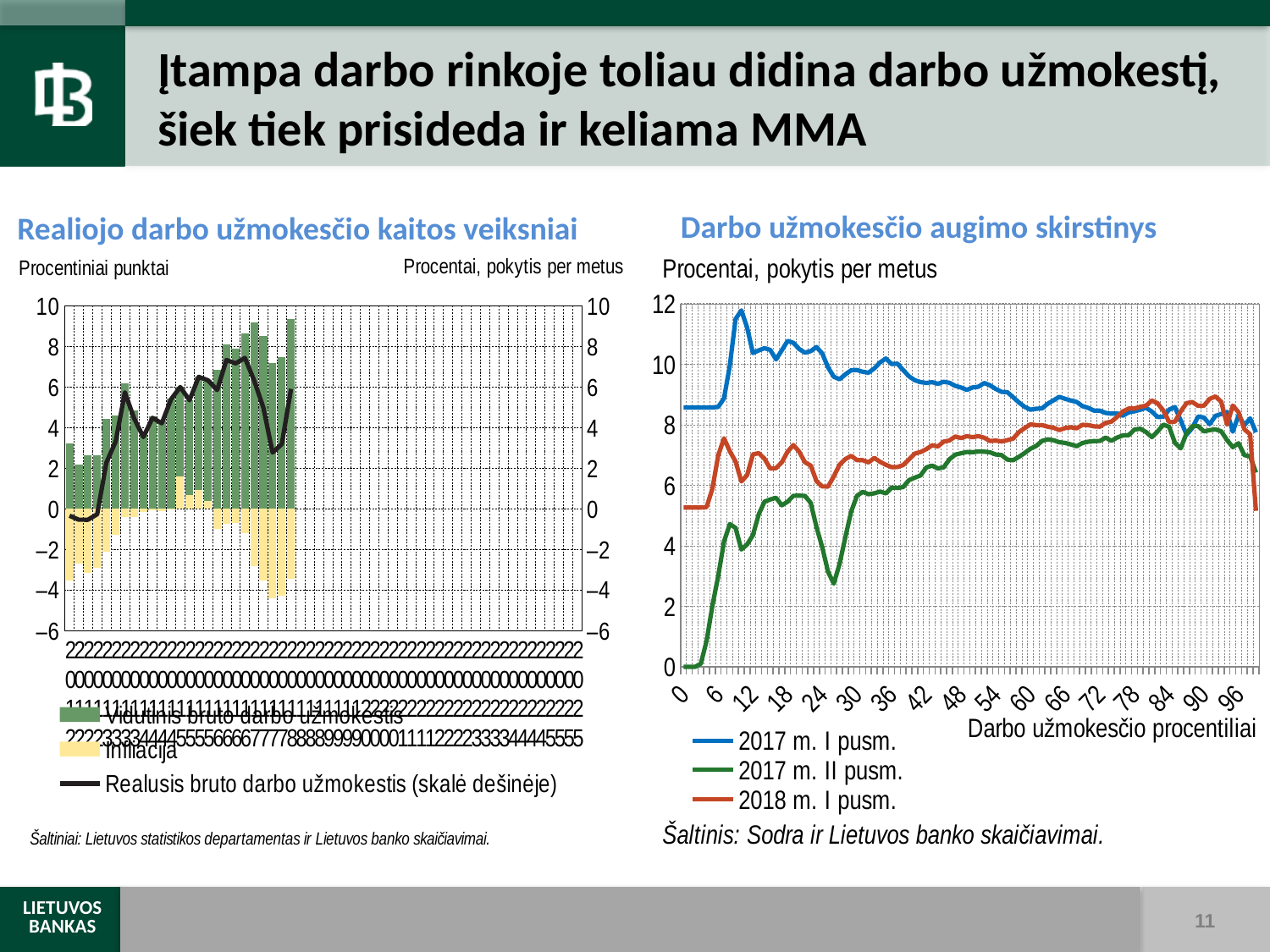
In the right-hand chart "Darbo užmokesčio augimo skirstinys", which series is plotted in red? 2018 m. I pusm. How many series does the legend of the left-hand chart "Realiojo darbo užmokesčio kaitos veiksniai" list? 3 In the right-hand chart "Darbo užmokesčio augimo skirstinys", at percentile 0, which is larger: the 2017 m. I pusm. value or the 2018 m. I pusm. value? 2017 m. I pusm. In the left-hand chart "Realiojo darbo užmokesčio kaitos veiksniai", which series is plotted as a black line on the right-hand scale? Realusis bruto darbo užmokestis (skalė dešinėje) In the right-hand chart "Darbo užmokesčio augimo skirstinys", does the 2017 m. II pusm. series overall rise or fall from percentile 0 to percentile 90? rise How many series does the legend of the right-hand chart "Darbo užmokesčio augimo skirstinys" list? 3 In the right-hand chart "Darbo užmokesčio augimo skirstinys", is the value of the 2017 m. II pusm. series at percentile 0 greater or less than 2? less In the right-hand chart "Darbo užmokesčio augimo skirstinys", which series has the highest value at percentile 12? 2017 m. I pusm. In the right-hand chart "Darbo užmokesčio augimo skirstinys", is the value of the 2017 m. I pusm. series at percentile 12 greater or less than 10? greater What kind of chart is the right-hand chart titled "Darbo užmokesčio augimo skirstinys"? line chart In the right-hand chart "Darbo užmokesčio augimo skirstinys", which series has the lowest value at percentile 24? 2017 m. II pusm. In the right-hand chart "Darbo užmokesčio augimo skirstinys", is the value of the 2018 m. I pusm. series at percentile 0 greater or less than 4? greater